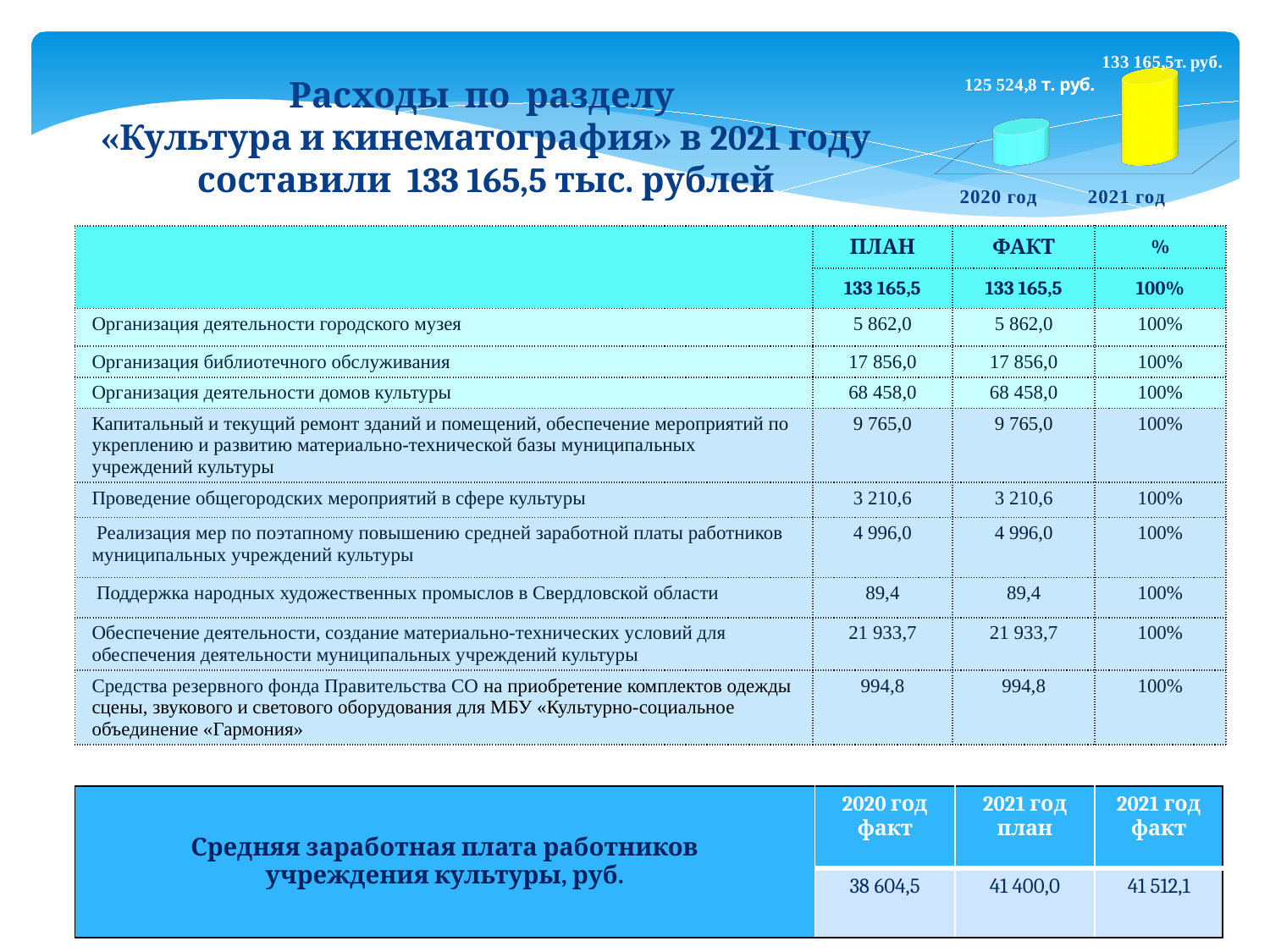
In the chart at the top right of the slide, do the values rise or fall from 2020 год to 2021 год? rise In the chart at the top right of the slide, what is the value for 2021 год? 133 165,5т. руб. In the chart at the top right of the slide, which year has the higher value? 2021 год What kind of chart is shown at the top right of the slide? bar chart In the chart at the top right of the slide, is the value for 2021 год larger or smaller than the value for 2020 год? larger In the chart at the top right of the slide, what is the value for 2020 год? 125 524,8 т. руб. In the chart at the top right of the slide, what colour is the bar for 2020 год? light blue In the chart at the top right of the slide, by how much does the 2021 год value exceed the 2020 год value? 7 640,7 т. руб. In the chart at the top right of the slide, which year has the lower value? 2020 год In the chart at the top right of the slide, what colour is the bar for 2021 год? yellow How many categories (years) are shown in the chart at the top right of the slide? 2